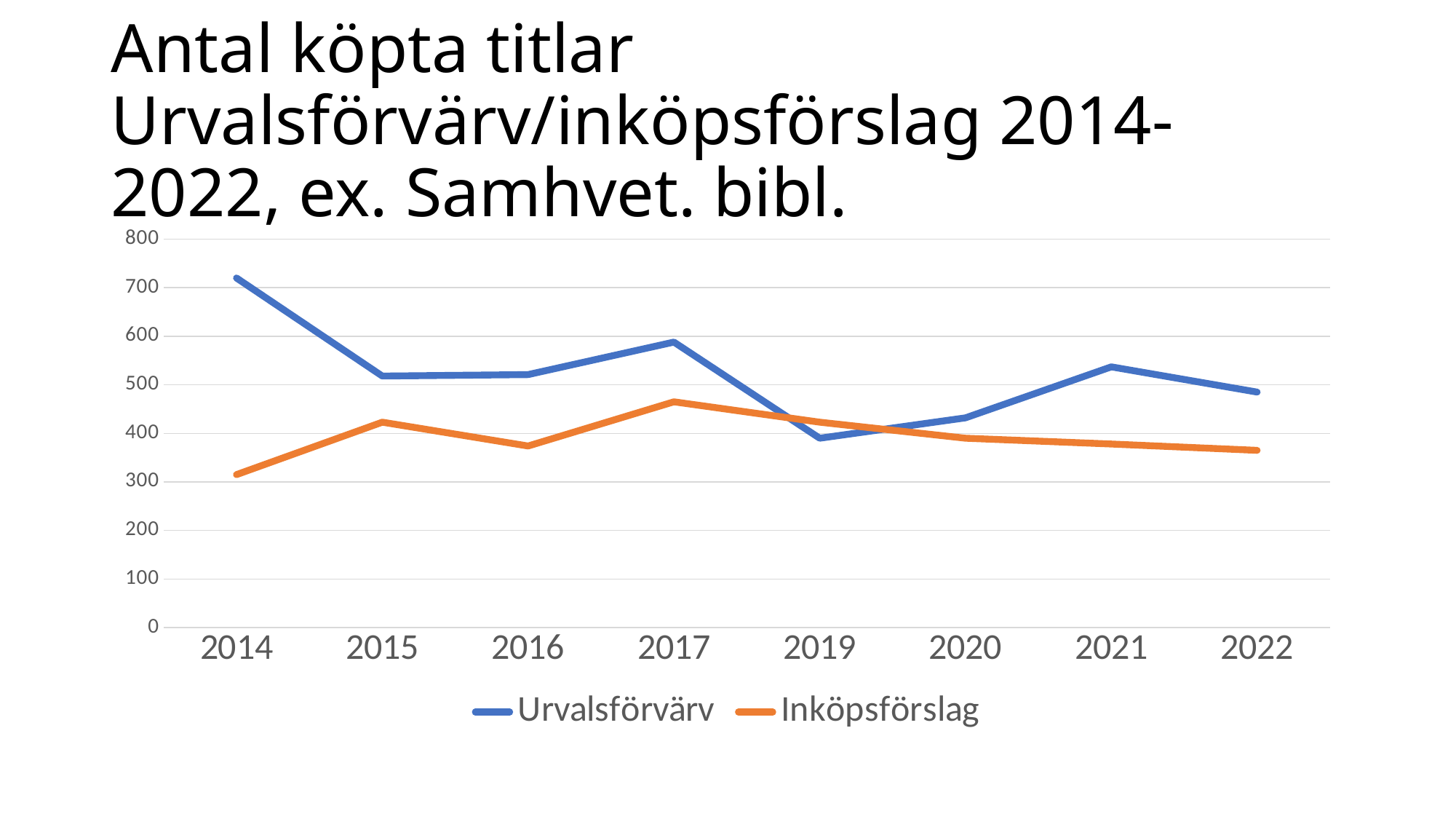
Which series has the larger value in 2019, Urvalsförvärv or Inköpsförslag? Inköpsförslag Which colour is used for the Inköpsförslag line? orange How many years are plotted along the x axis? 8 In which year is the Inköpsförslag series at its lowest? 2014 Is the value for Inköpsförslag in 2022 greater or less than 400? less In which year is the Urvalsförvärv series at its highest? 2014 In which year is the Urvalsförvärv series at its lowest? 2019 Does the Urvalsförvärv series rise or fall from 2014 to 2015? fall How many series does the legend list? 2 Is the value for Urvalsförvärv in 2014 greater or less than 700? greater What kind of chart is shown on the slide? line chart In which year is the Inköpsförslag series at its highest? 2017